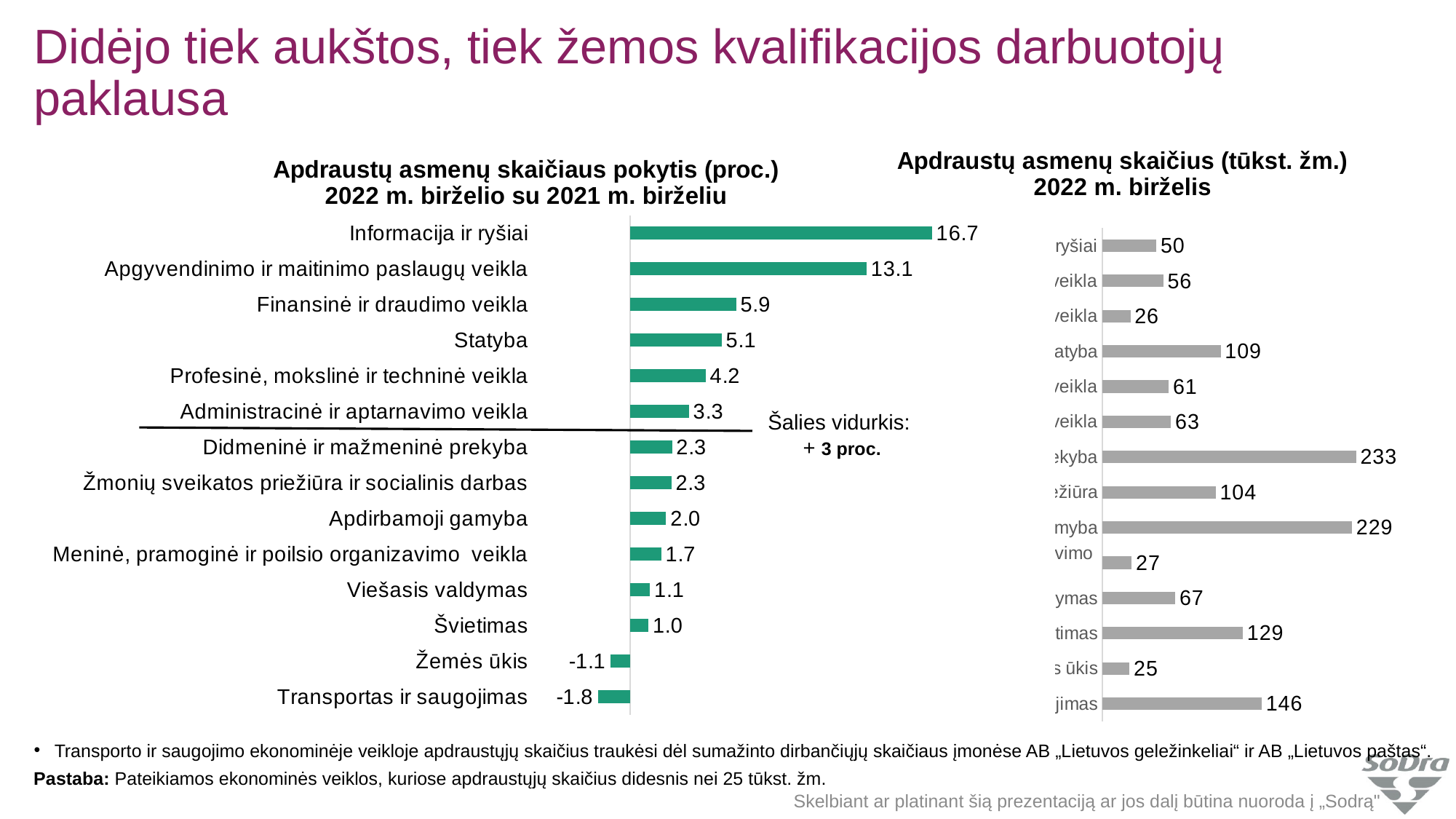
In the chart 'Apdraustų asmenų skaičiaus pokytis (proc.)', what is the difference between the values for Informacija ir ryšiai and Apgyvendinimo ir maitinimo paslaugų veikla? 3.6 In the right chart 'Apdraustų asmenų skaičius (tūkst. žm.) 2022 m. birželis', what is the highest value shown? 233 In the right chart 'Apdraustų asmenų skaičius (tūkst. žm.) 2022 m. birželis', what is the lowest value shown? 25 In the chart 'Apdraustų asmenų skaičiaus pokytis (proc.)', what is the value for Transportas ir saugojimas? -1.8 How many categories are shown in the chart 'Apdraustų asmenų skaičiaus pokytis (proc.)'? 14 What kind of chart is the left chart 'Apdraustų asmenų skaičiaus pokytis (proc.)'? Bar chart In the chart 'Apdraustų asmenų skaičiaus pokytis (proc.)', which category has the highest value? Informacija ir ryšiai What national average (Šalies vidurkis) is noted on the left chart? + 3 proc. In the chart 'Apdraustų asmenų skaičiaus pokytis (proc.)', which category has the lowest value? Transportas ir saugojimas In the chart 'Apdraustų asmenų skaičiaus pokytis (proc.)', what is the value for Statyba? 5.1 In the chart 'Apdraustų asmenų skaičiaus pokytis (proc.)', what is the value for Informacija ir ryšiai? 16.7 In the chart 'Apdraustų asmenų skaičiaus pokytis (proc.)', which is larger: the value for Finansinė ir draudimo veikla or the value for Profesinė, mokslinė ir techninė veikla? Finansinė ir draudimo veikla